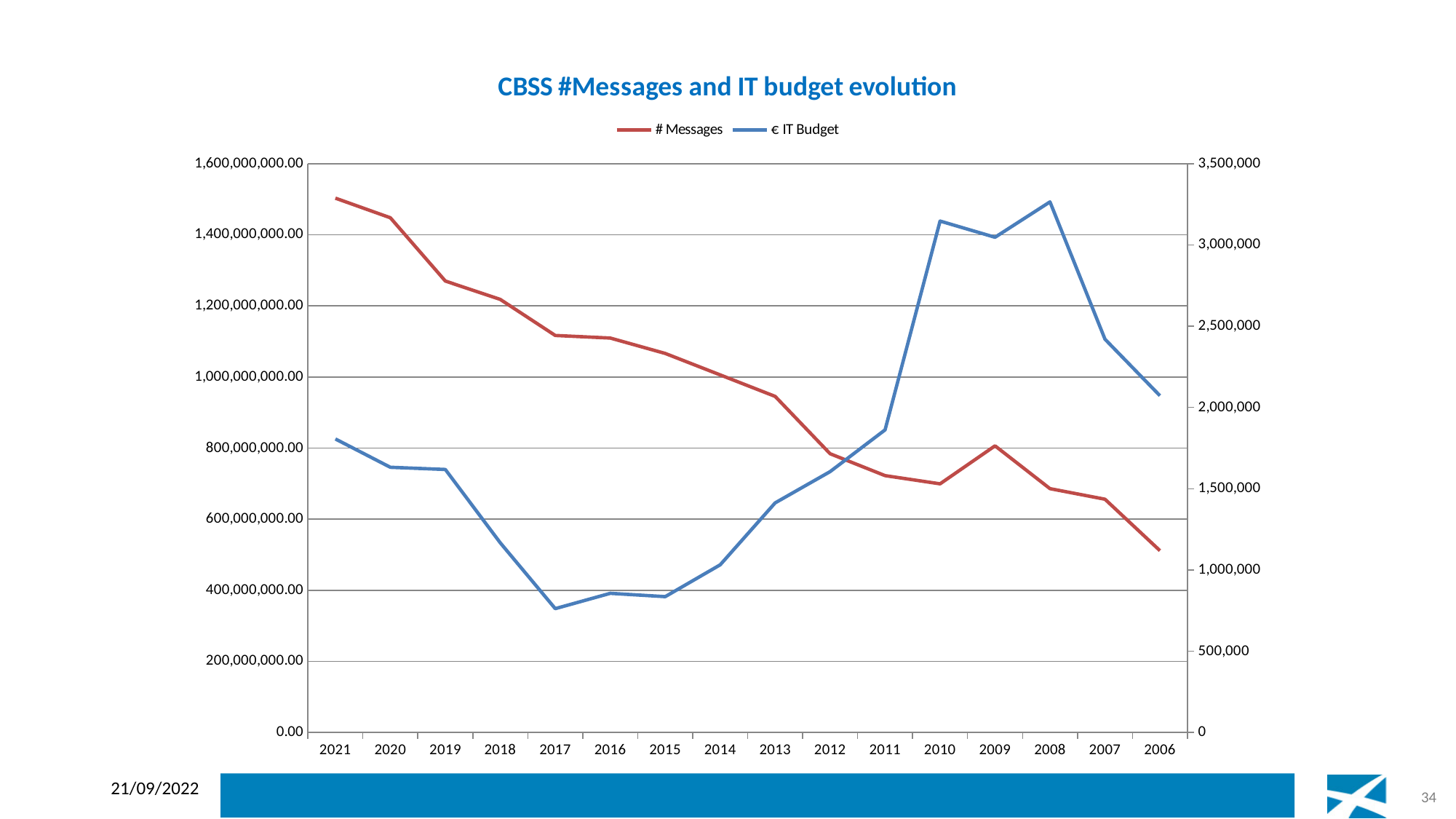
Is the value for # Messages in 2021 greater or less than 1,400,000,000.00? greater Is the value for € IT Budget in 2017 greater or less than 1,000,000? less How many years are shown on the x axis? 16 Which is larger, the # Messages value for 2009 or for 2010? 2009 Is the value for € IT Budget in 2010 greater or less than 3,000,000? greater Which year has the highest value for # Messages? 2021 Which year has the lowest value for € IT Budget? 2017 Which year has the lowest value for # Messages? 2006 What is the title of the chart? CBSS #Messages and IT budget evolution What kind of chart is shown on the slide? line chart Which year has the highest value for € IT Budget? 2008 How many series does the legend list? 2